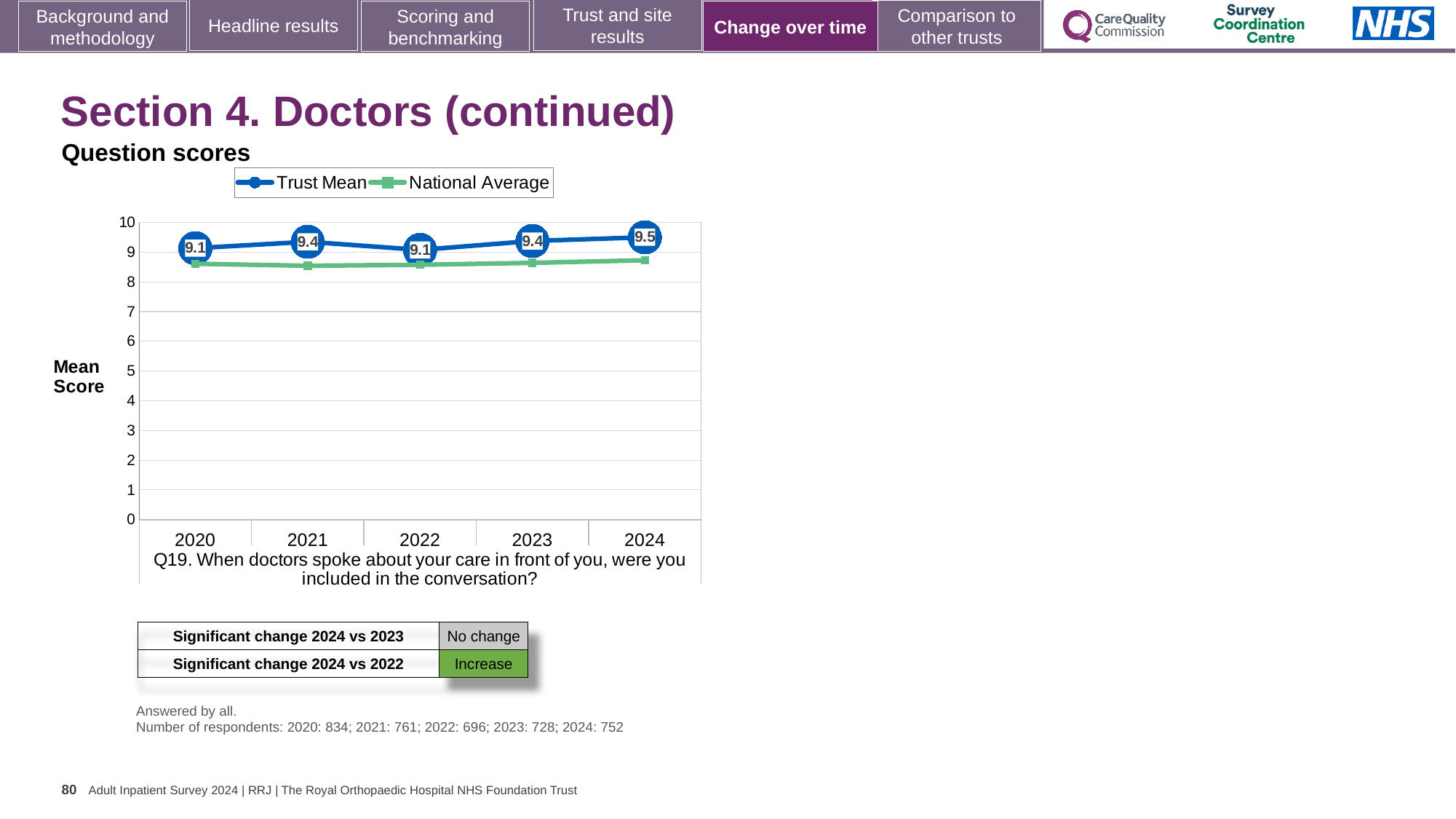
What is the label on the y axis of the chart? Mean Score What is the Trust Mean score for 2020? 9.1 How many years are plotted on the x axis? 5 What kind of chart is shown on the slide? line chart What is the Trust Mean score for 2024? 9.5 What is the lowest Trust Mean score shown on the chart? 9.1 What is the difference between the Trust Mean score in 2024 and in 2020? 0.4 What is the Trust Mean score for 2021? 9.4 How many series does the legend list? 2 In which year is the Trust Mean score highest? 2024 Which year has the larger Trust Mean score, 2021 or 2022? 2021 Is the National Average value for 2024 greater or less than 8? greater